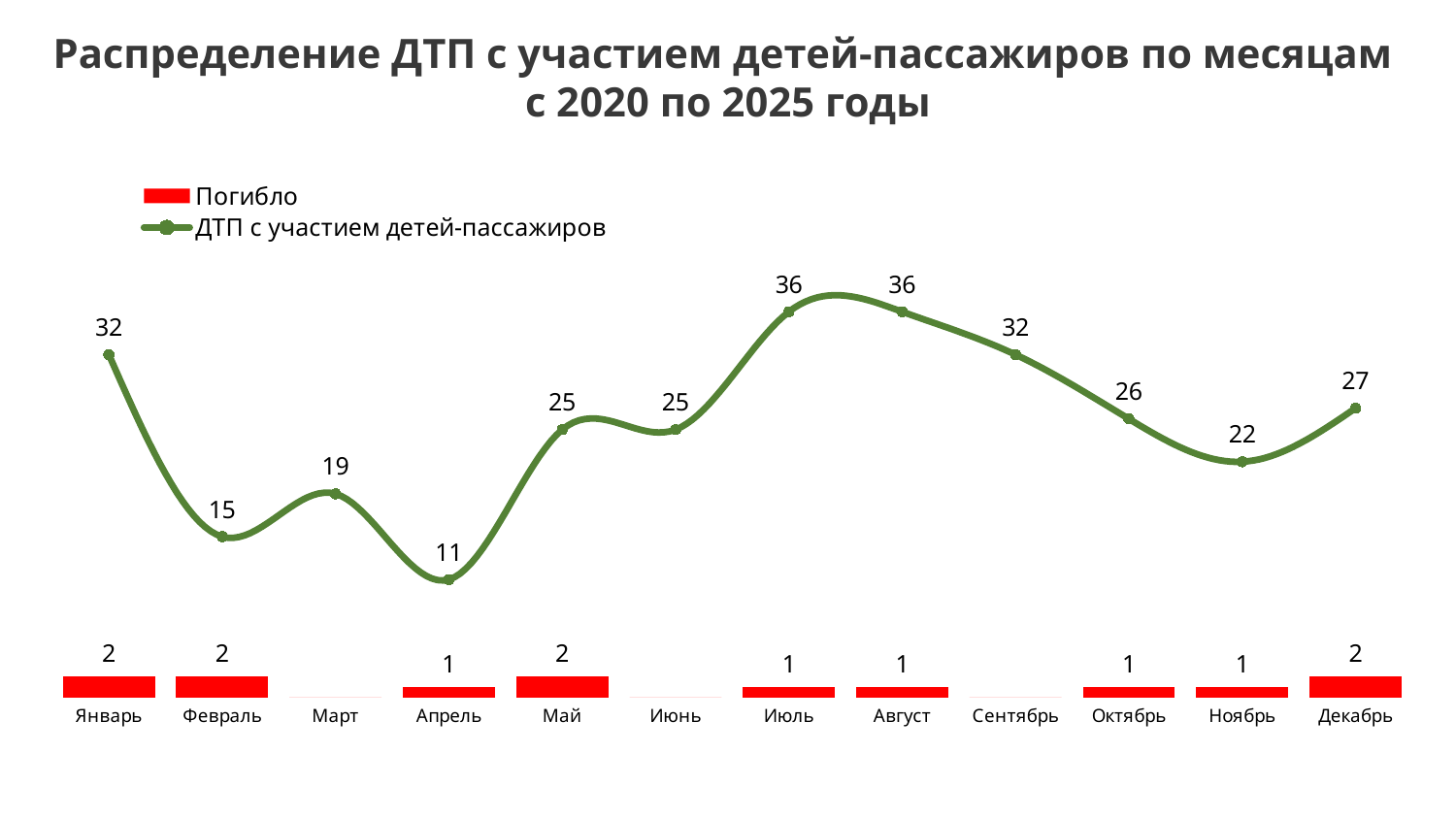
What colour are the Погибло bars? red Which is larger, the ДТП с участием детей-пассажиров value for Январь or for Декабрь? Январь How many series does the legend list? 2 What is the value of ДТП с участием детей-пассажиров for Апрель? 11 What is the highest value shown on the ДТП с участием детей-пассажиров line? 36 What is the value of ДТП с участием детей-пассажиров for Сентябрь? 32 What kind of chart is used for the ДТП с участием детей-пассажиров series? line chart How many months are shown on the x axis? 12 Which month has the lowest value of ДТП с участием детей-пассажиров? Апрель Does the ДТП с участием детей-пассажиров line rise or fall from Август to Ноябрь? fall What is the value of Погибло for Май? 2 What is the difference between the ДТП с участием детей-пассажиров values for Июль and Ноябрь? 14